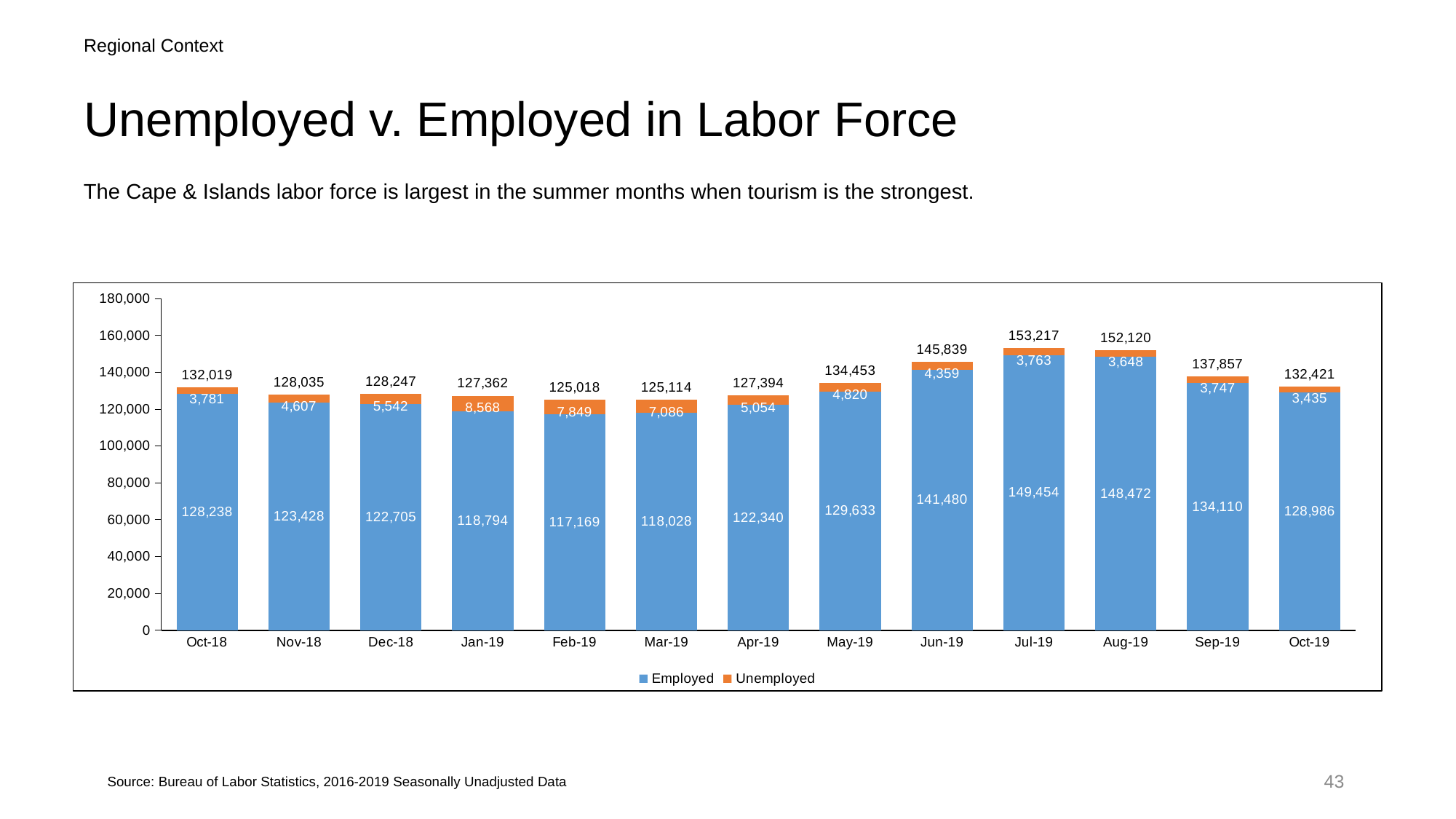
How many months are shown on the x axis? 13 What is the difference between the Unemployed values for Jan-19 and Oct-19? 5,133 What is the Employed value for Jul-19? 149,454 Which month has the highest total labor force? Jul-19 What is the Unemployed value for Jan-19? 8,568 How many series does the legend list? 2 Which month has the lowest Employed value? Feb-19 Which month has the highest Unemployed value? Jan-19 What is the total labor force (Employed plus Unemployed) for Jun-19? 145,839 What kind of chart is shown on the slide? Stacked bar chart Which month has the larger Employed value, Oct-18 or Oct-19? Oct-19 What is the difference between the Employed values for Jul-19 and Aug-19? 982